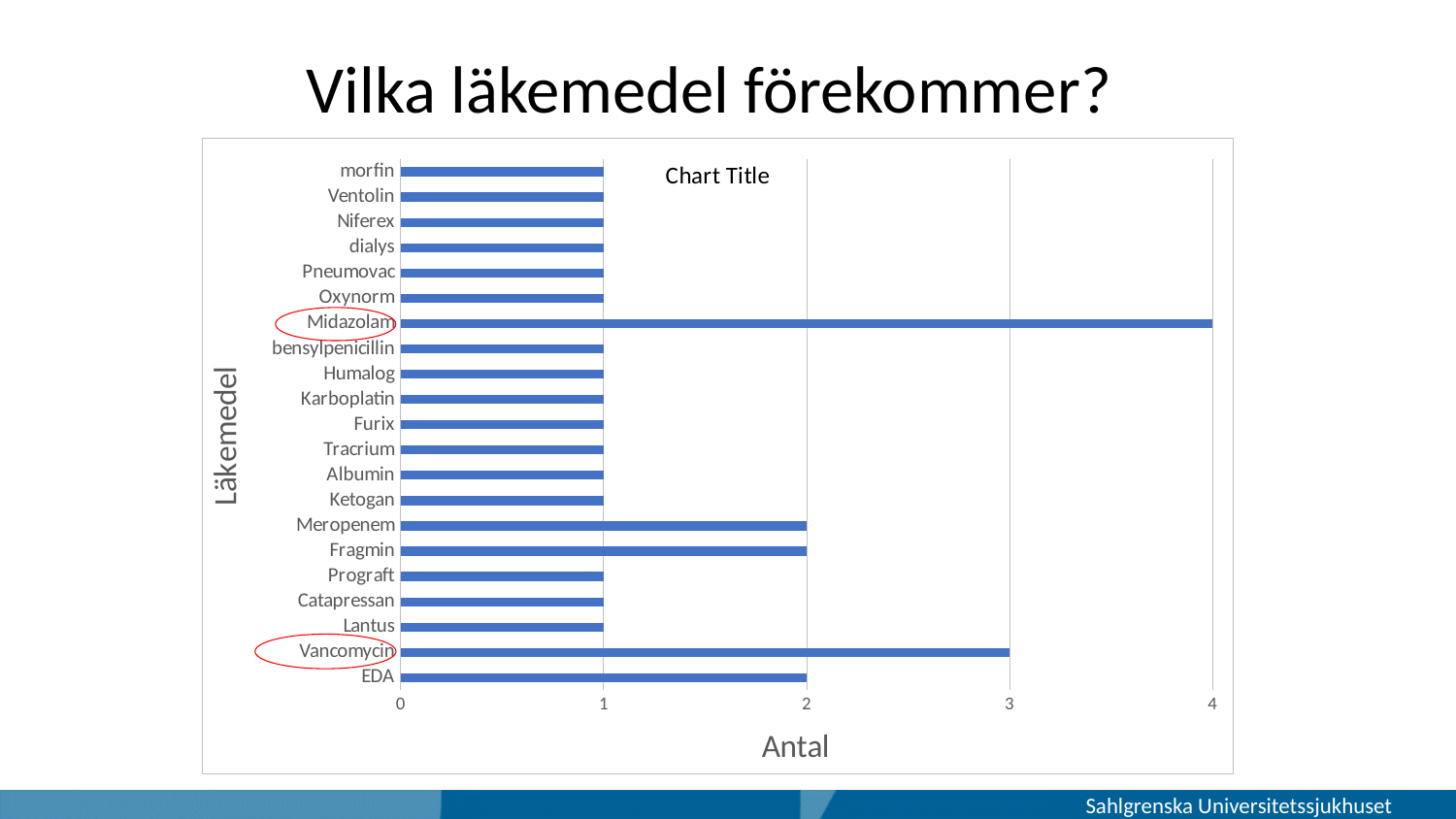
How many categories are shown on the chart? 21 What is the value for Lantus? 1 Is the value for Midazolam greater or less than 3? greater What is the value for Midazolam? 4 What is the title of the horizontal axis? Antal Which category has the highest value? Midazolam What is the value for EDA? 2 What is the value for Fragmin? 2 What is the value for Vancomycin? 3 What kind of chart is shown on the slide? bar chart What is the difference between the values for Midazolam and Vancomycin? 1 Which is larger, the value for Vancomycin or the value for Meropenem? Vancomycin